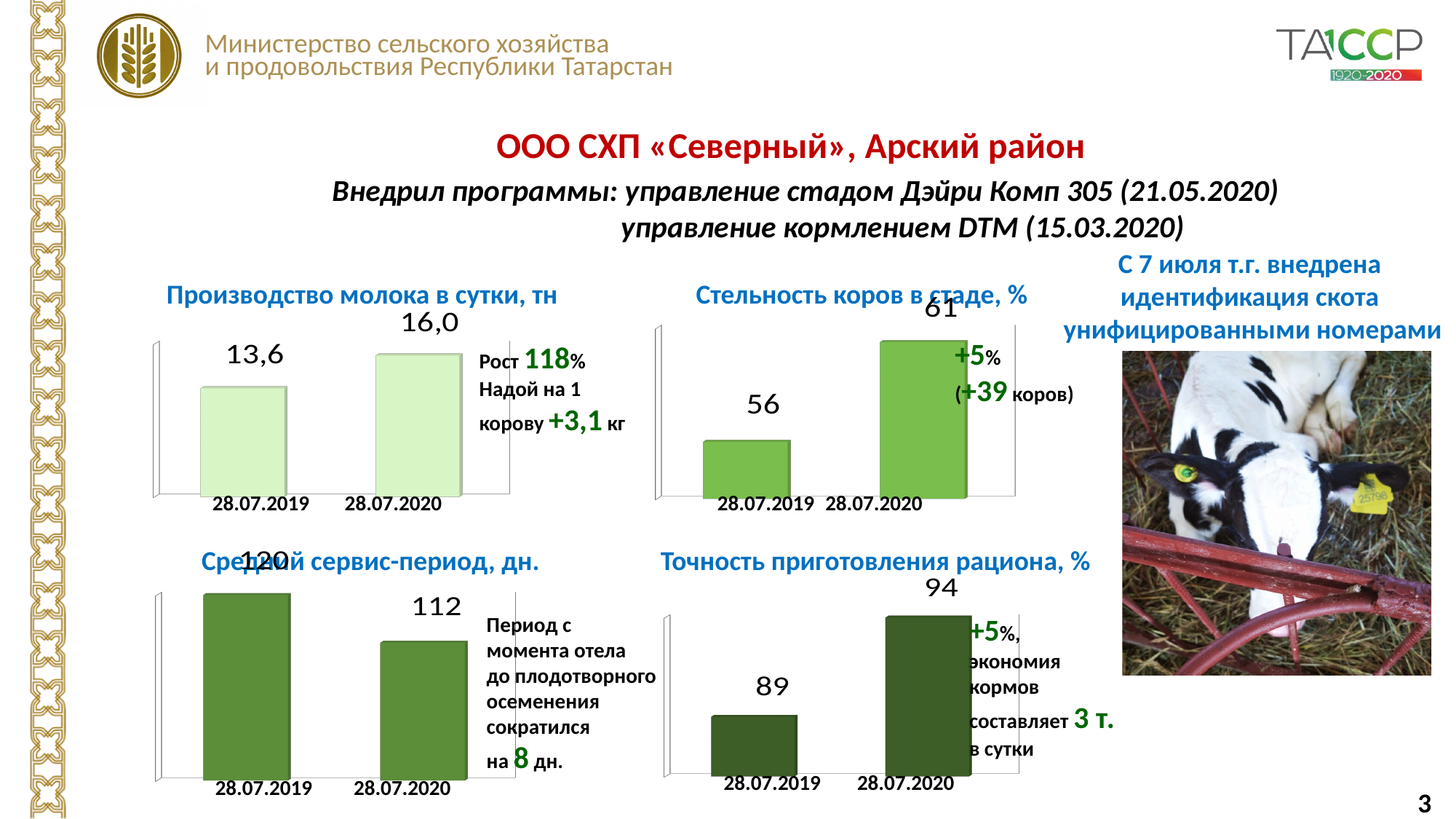
In the chart titled «Производство молока в сутки, тн», what is the value for 28.07.2020? 16,0 In the chart titled «Производство молока в сутки, тн», what is the value for 28.07.2019? 13,6 In the chart titled «Стельность коров в стаде, %», what is the value for 28.07.2019? 56 In the chart titled «Точность приготовления рациона, %», which date has the highest value? 28.07.2020 In the chart titled «Точность приготовления рациона, %», what is the difference between the 28.07.2020 and 28.07.2019 values? 5 How many bars are shown in the chart titled «Производство молока в сутки, тн»? 2 In the chart titled «Стельность коров в стаде, %», what is the difference between the 28.07.2020 and 28.07.2019 values? 5 What kind of chart is the one titled «Стельность коров в стаде, %»? bar chart In the chart titled «Средний сервис-период, дн.», what is the value for 28.07.2019? 120 In the chart titled «Средний сервис-период, дн.», do the values rise or fall from 28.07.2019 to 28.07.2020? fall In the chart titled «Средний сервис-период, дн.», which date has the lowest value? 28.07.2020 In the chart titled «Точность приготовления рациона, %», what is the value for 28.07.2020? 94